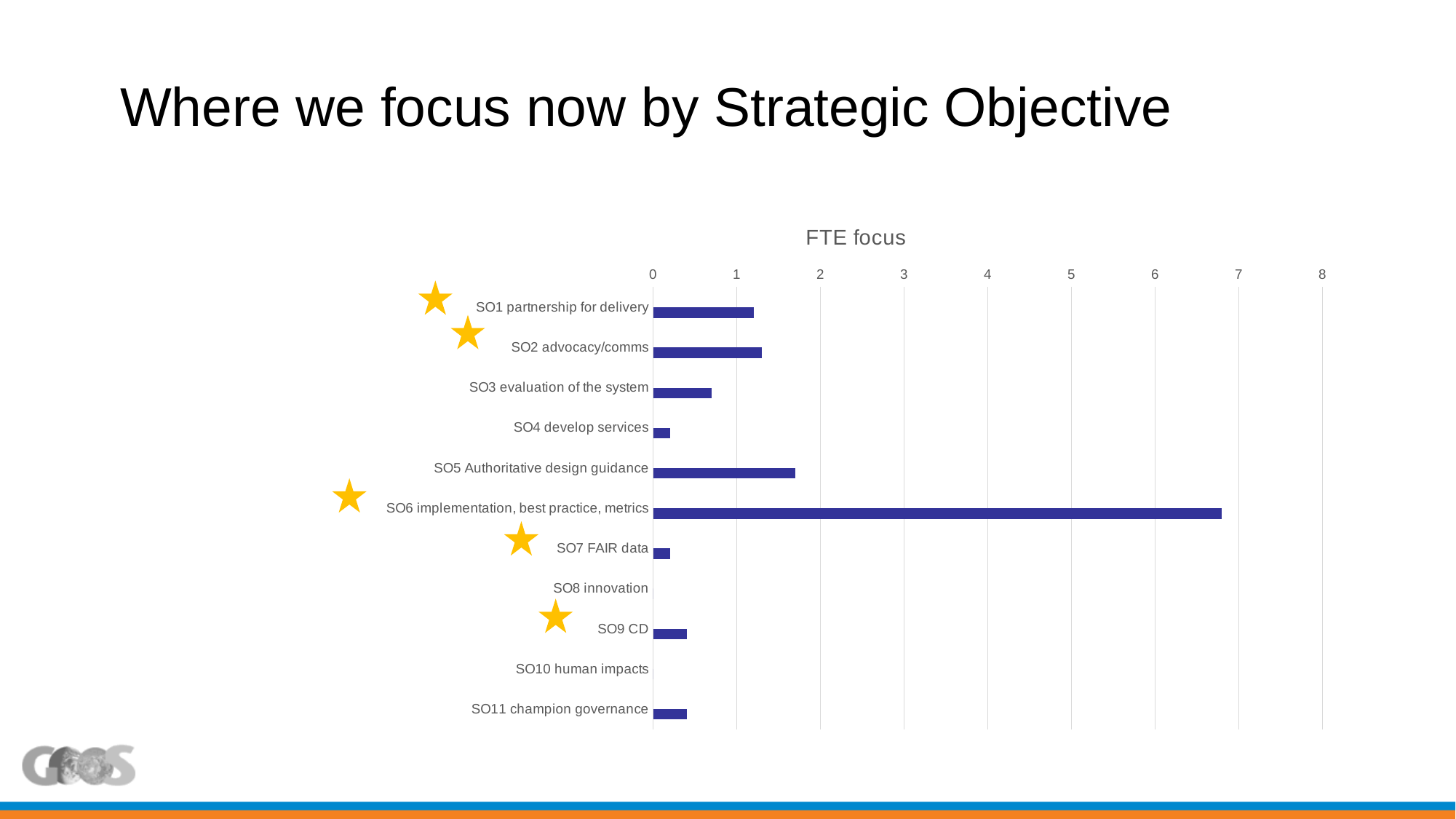
What is the title of the chart? FTE focus Is the value for SO6 implementation, best practice, metrics greater or less than 6? greater Which has a larger FTE focus, SO5 Authoritative design guidance or SO3 evaluation of the system? SO5 Authoritative design guidance Which strategic objective has the highest FTE focus? SO6 implementation, best practice, metrics Which has a larger FTE focus, SO2 advocacy/comms or SO4 develop services? SO2 advocacy/comms Is the value for SO9 CD greater or less than 1? less Is the value for SO3 evaluation of the system greater or less than 1? less What is the highest value shown on the chart's horizontal axis? 8 What kind of chart is shown on the slide? bar chart How many strategic objective categories are listed on the chart? 11